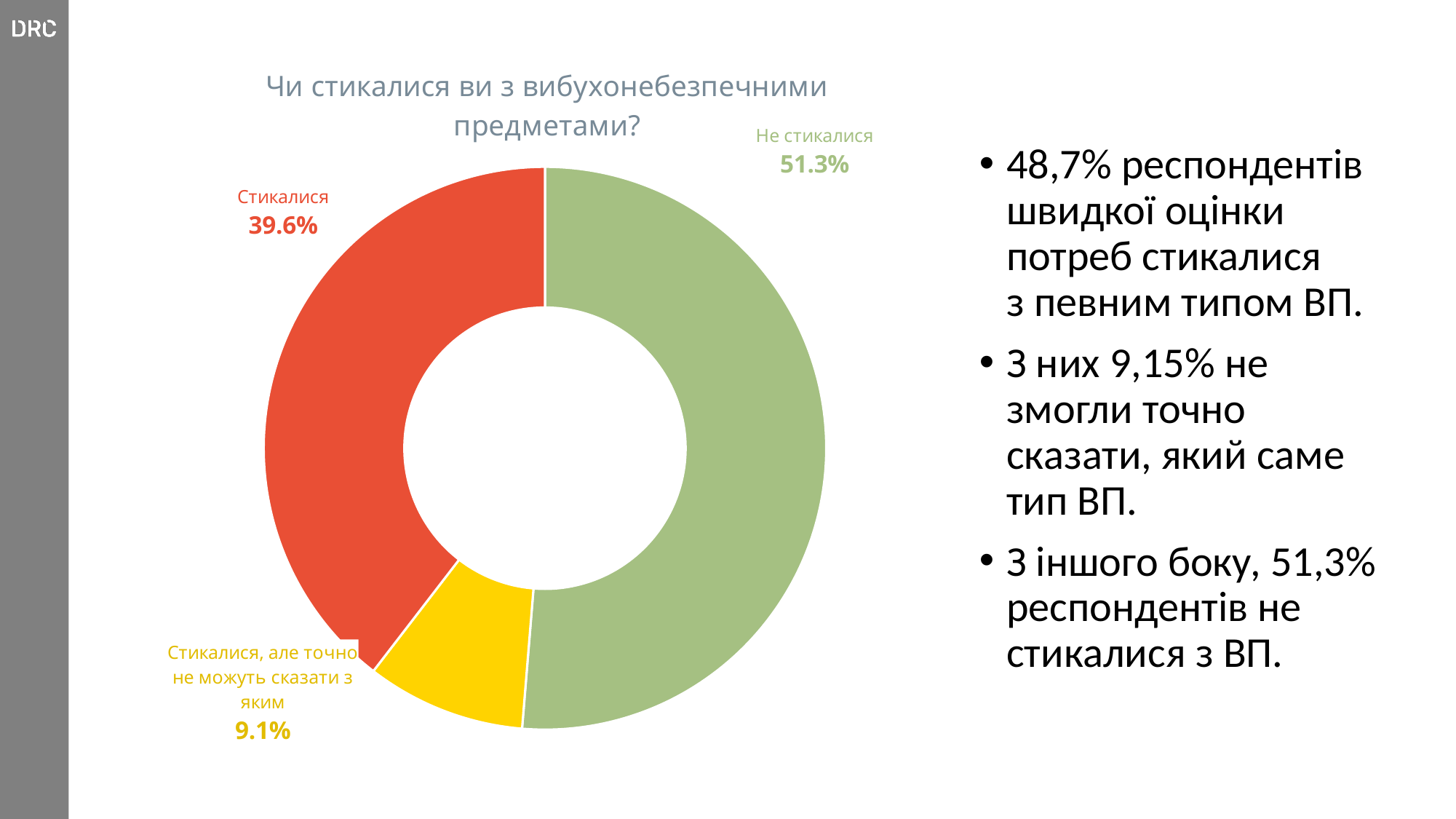
Which category has the smallest share of the chart? Стикалися, але точно не можуть сказати з яким What percentage of respondents answered "Стикалися, але точно не можуть сказати з яким"? 9.1% What is the title of the chart? Чи стикалися ви з вибухонебезпечними предметами? What percentage of respondents answered "Не стикалися"? 51.3% What is the difference in percentage points between "Не стикалися" and "Стикалися"? 11.7 What is the combined share of "Стикалися" and "Стикалися, але точно не можуть сказати з яким"? 48.7% Which is larger: the share for "Стикалися" or the share for "Стикалися, але точно не можуть сказати з яким"? Стикалися What colour is the slice for "Не стикалися"? green What percentage of respondents answered "Стикалися"? 39.6% How many categories (slices) does the chart have? 3 Which category has the largest share of the chart? Не стикалися What type of chart is shown on the slide? pie chart (donut)